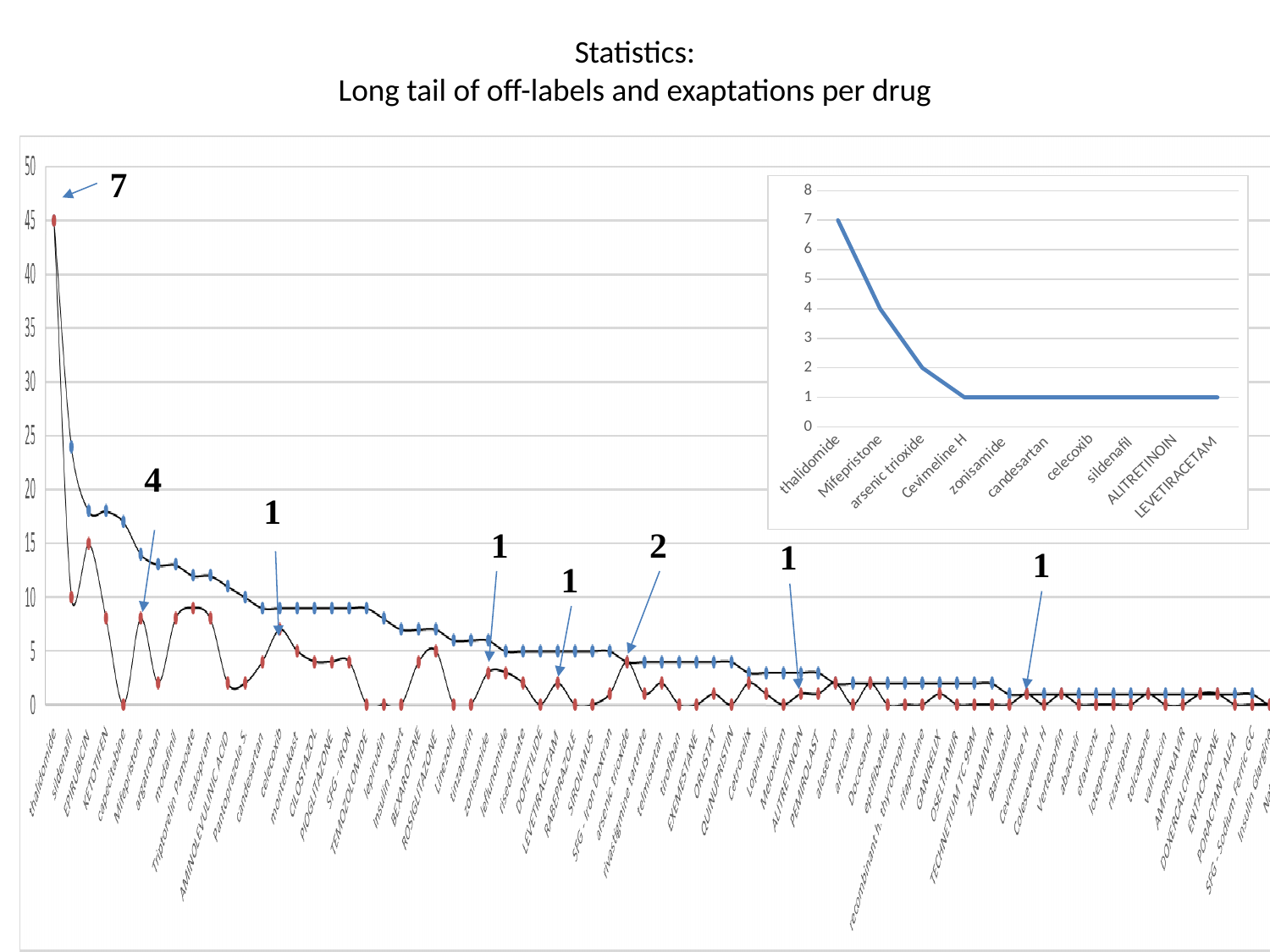
In the inset chart at the top right, what is the value for arsenic trioxide? 2 In the inset chart at the top right, what is the value for celecoxib? 1 In the main chart, is the value plotted for thalidomide greater or less than 40? greater In the inset chart at the top right, what is the value for Mifepristone? 4 In the inset chart at the top right, which drug has the highest value? thalidomide In the main chart, which drug has the highest plotted value? thalidomide In the inset chart at the top right, what is the value for thalidomide? 7 In the inset chart at the top right, what is the difference between the values for thalidomide and Mifepristone? 3 What kind of chart is the inset chart at the top right? line chart What kind of chart is the main chart on the slide? line chart In the inset chart at the top right, do the values rise or fall from left to right along the x axis? fall In the inset chart at the top right, how many drugs are shown on the x axis? 10